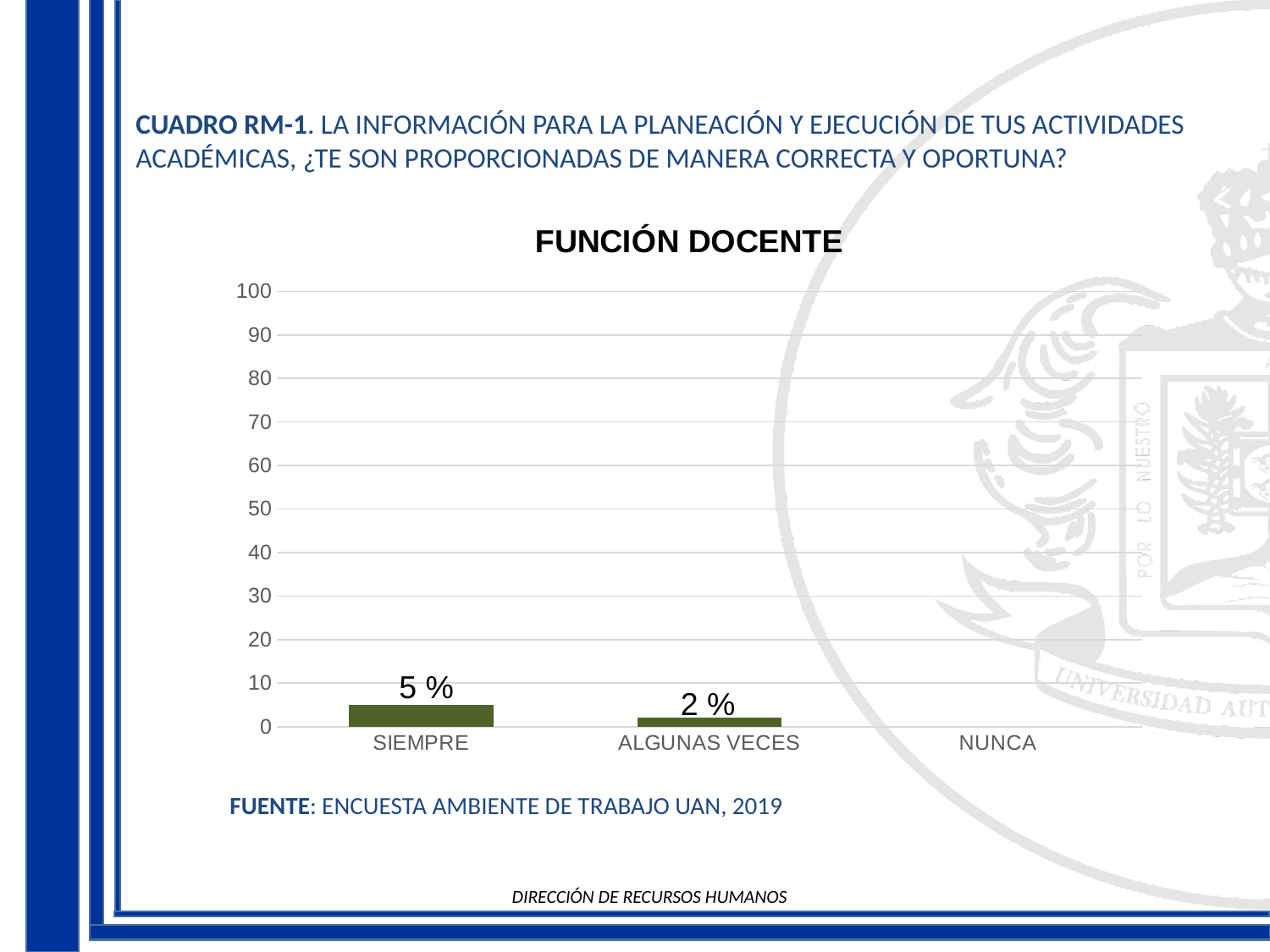
Is the value for ALGUNAS VECES in the FUNCIÓN DOCENTE chart greater or less than 10? less Is the value for SIEMPRE in the FUNCIÓN DOCENTE chart greater or less than 10? less What kind of chart is the FUNCIÓN DOCENTE chart? bar chart Which category has the highest value in the FUNCIÓN DOCENTE chart? SIEMPRE Which is larger in the FUNCIÓN DOCENTE chart, SIEMPRE or ALGUNAS VECES? SIEMPRE What is the title of the chart on the slide? FUNCIÓN DOCENTE Do the values in the FUNCIÓN DOCENTE chart rise or fall from left to right along the x axis? fall What is the difference between the values for SIEMPRE and ALGUNAS VECES in the FUNCIÓN DOCENTE chart? 3 % What is the value for SIEMPRE in the FUNCIÓN DOCENTE chart? 5 % What is the value for ALGUNAS VECES in the FUNCIÓN DOCENTE chart? 2 % What is the highest value shown on the vertical axis of the FUNCIÓN DOCENTE chart? 100 How many categories are shown on the x axis of the FUNCIÓN DOCENTE chart? 3